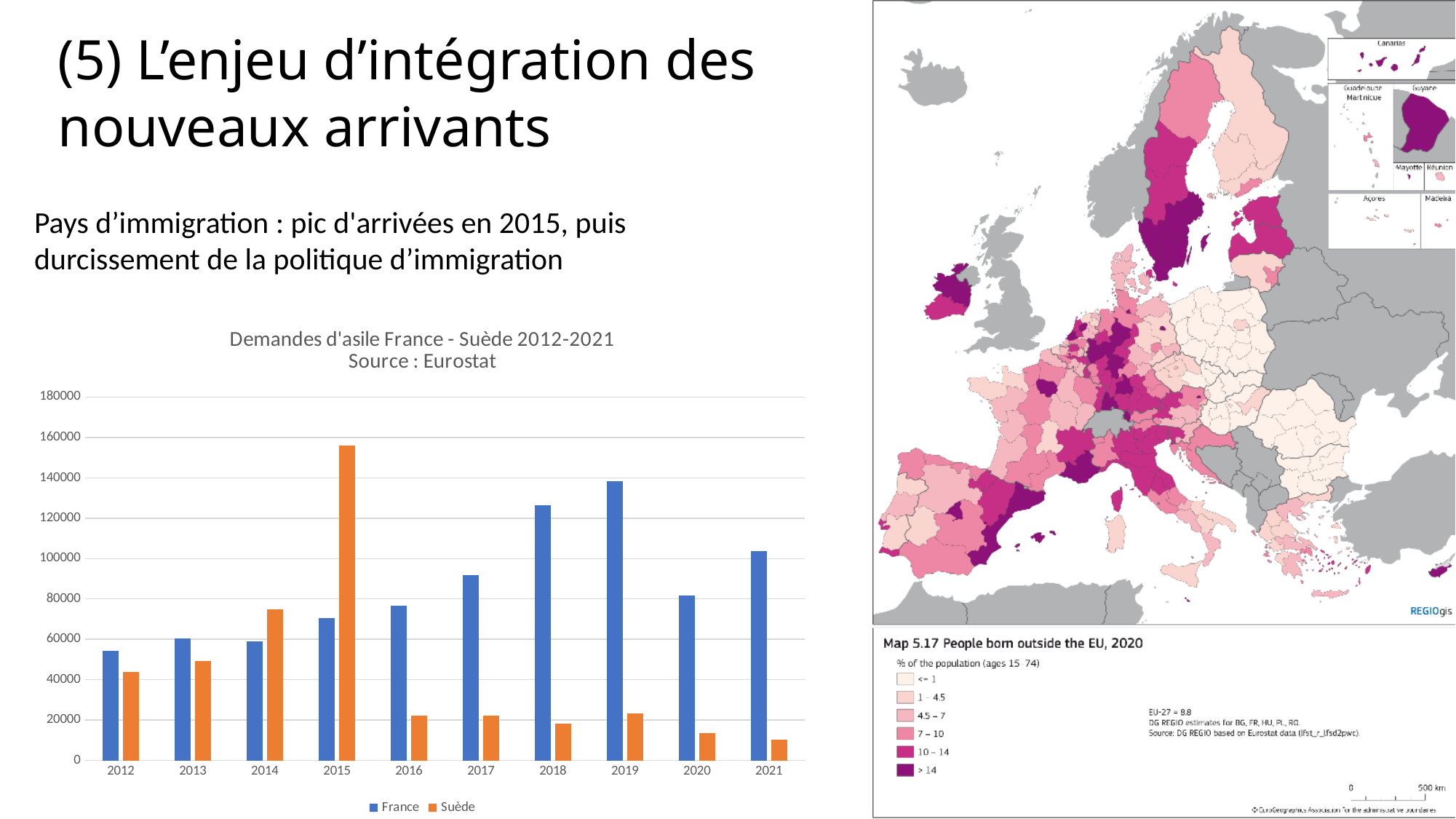
Is the value for Suède in 2015 greater or less than 140000? greater How many series does the legend of the bar chart list? 2 In 2019, which series has the larger value, France or Suède? France Is the value for Suède in 2021 greater or less than 20000? less In which year is the value for Suède highest? 2015 What kind of chart is shown on the slide? bar chart Which colour represents Suède in the bar chart? orange Do the values for Suède rise or fall from 2015 to 2021? fall How many years are shown on the x axis of the bar chart? 10 In which year is the value for Suède lowest? 2021 In which year is the value for France highest? 2019 In 2015, which series has the larger value, France or Suède? Suède